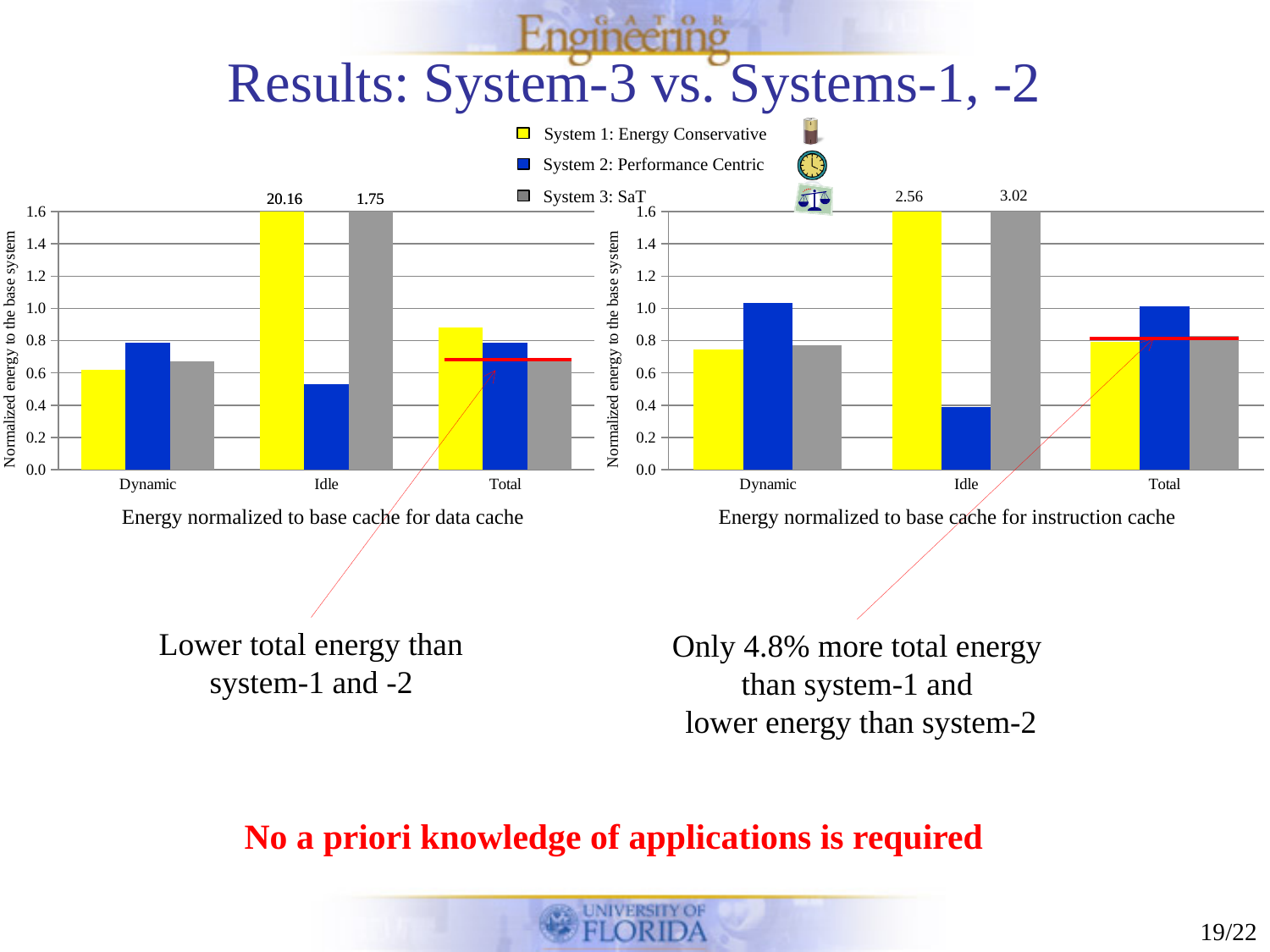
In the chart titled 'Energy normalized to base cache for instruction cache', what is the difference between the Idle values of System 3 and System 1? 0.46 How many categories are shown on the x axis of the chart titled 'Energy normalized to base cache for data cache'? 3 In the chart titled 'Energy normalized to base cache for instruction cache', is the Dynamic value for System 2 greater or less than 0.8? greater In the chart titled 'Energy normalized to base cache for data cache', is the Idle value for System 2 greater or less than 0.6? less How many series does the legend list for the charts on this slide? 3 In the chart titled 'Energy normalized to base cache for instruction cache', what is the value printed for System 1 in the Idle category? 2.56 In the chart titled 'Energy normalized to base cache for data cache', what is the difference between the Idle values of System 1 and System 3? 18.41 In the chart titled 'Energy normalized to base cache for data cache', what is the value printed for System 1 in the Idle category? 20.16 In the chart titled 'Energy normalized to base cache for instruction cache', what is the value printed for System 3 in the Idle category? 3.02 In the chart titled 'Energy normalized to base cache for data cache', what is the value printed for System 3 in the Idle category? 1.75 In the chart titled 'Energy normalized to base cache for data cache', which system has the lowest Idle value? System 2 In the chart titled 'Energy normalized to base cache for instruction cache', which system has the higher Idle value, System 1 or System 3? System 3